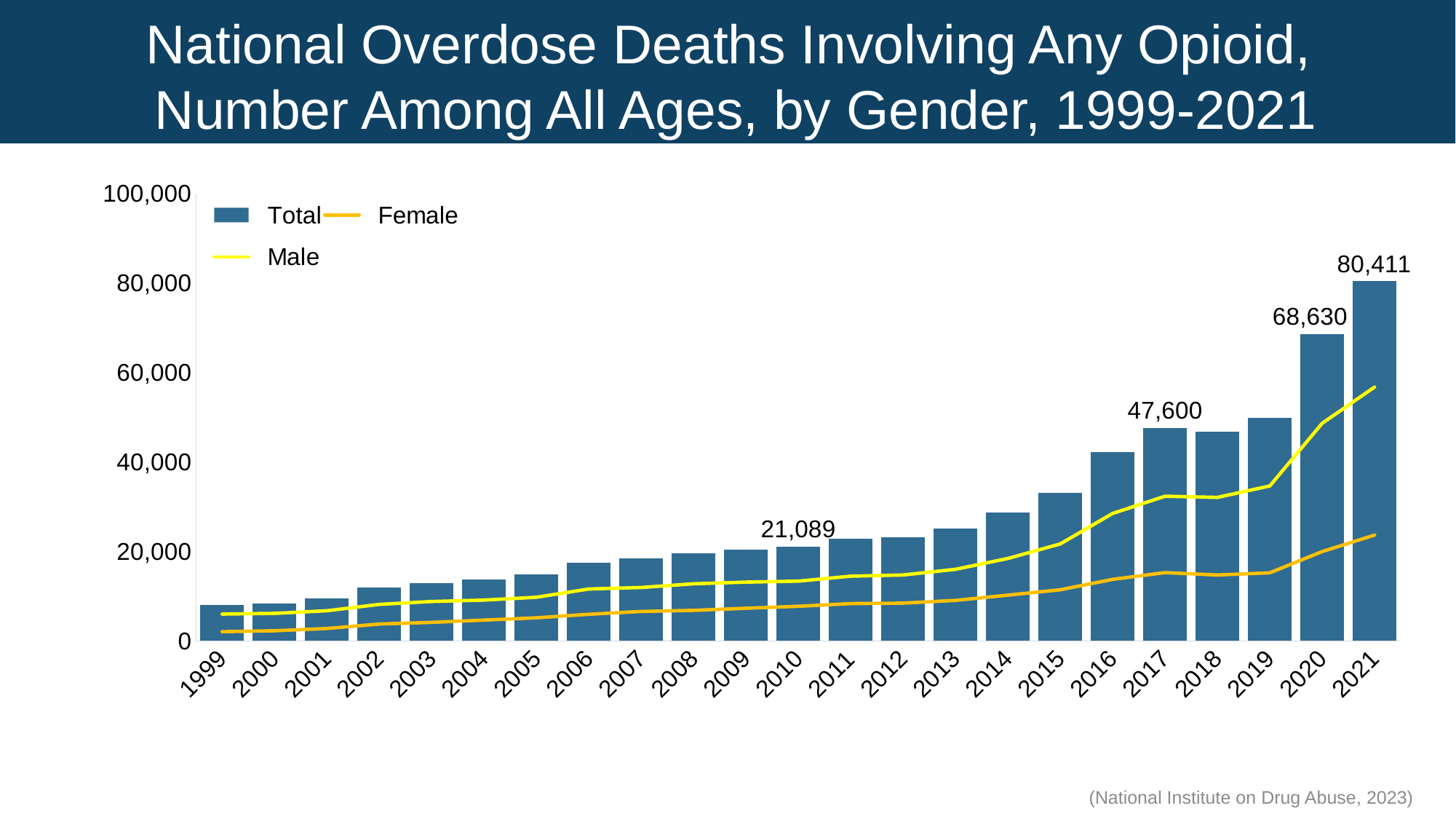
What is the difference between the total deaths in 2017 and in 2010? 26,511 How many series does the legend list? 3 What was the total number of opioid overdose deaths in 2020? 68,630 In 2021, which line is higher, Male or Female? Male Is the total number of deaths in 2015 greater or less than 40,000? less Which year has the highest total number of opioid overdose deaths? 2021 What was the total number of opioid overdose deaths in 2017? 47,600 By how much did the total number of opioid overdose deaths increase from 2020 to 2021? 11,781 Overall, do the total deaths rise or fall from 1999 to 2021? rise What was the total number of opioid overdose deaths in 2021? 80,411 How many years are shown on the x axis? 23 What was the total number of opioid overdose deaths in 2010? 21,089